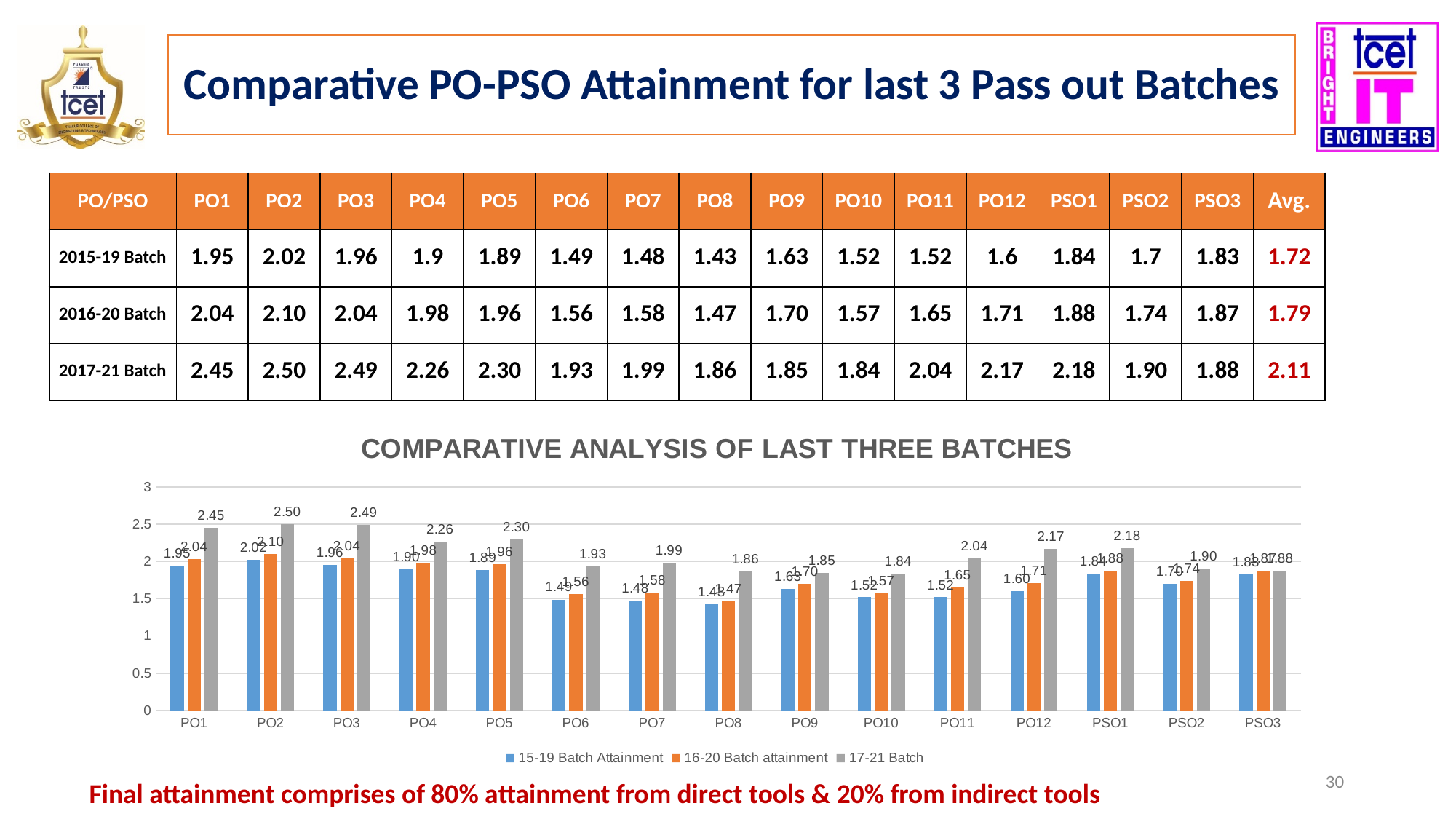
What is the difference between the 17-21 Batch value and the 16-20 Batch attainment value at PO1? 0.41 How many series does the chart legend list? 3 What kind of chart is shown on the slide? Bar chart Which category has the lowest value for the 17-21 Batch series? PO10 What is the title of the chart? COMPARATIVE ANALYSIS OF LAST THREE BATCHES What is the value for the 17-21 Batch series at PSO1? 2.18 Is the value for the 15-19 Batch Attainment series at PO8 greater or less than 1.5? less How many categories are shown on the x axis of the chart? 15 Which is larger at PO7: the 17-21 Batch value or the 16-20 Batch attainment value? 17-21 Batch What is the value for the 17-21 Batch series at PO6? 1.93 Which category has the highest value for the 17-21 Batch series? PO2 What is the value for the 17-21 Batch series at PO2? 2.50